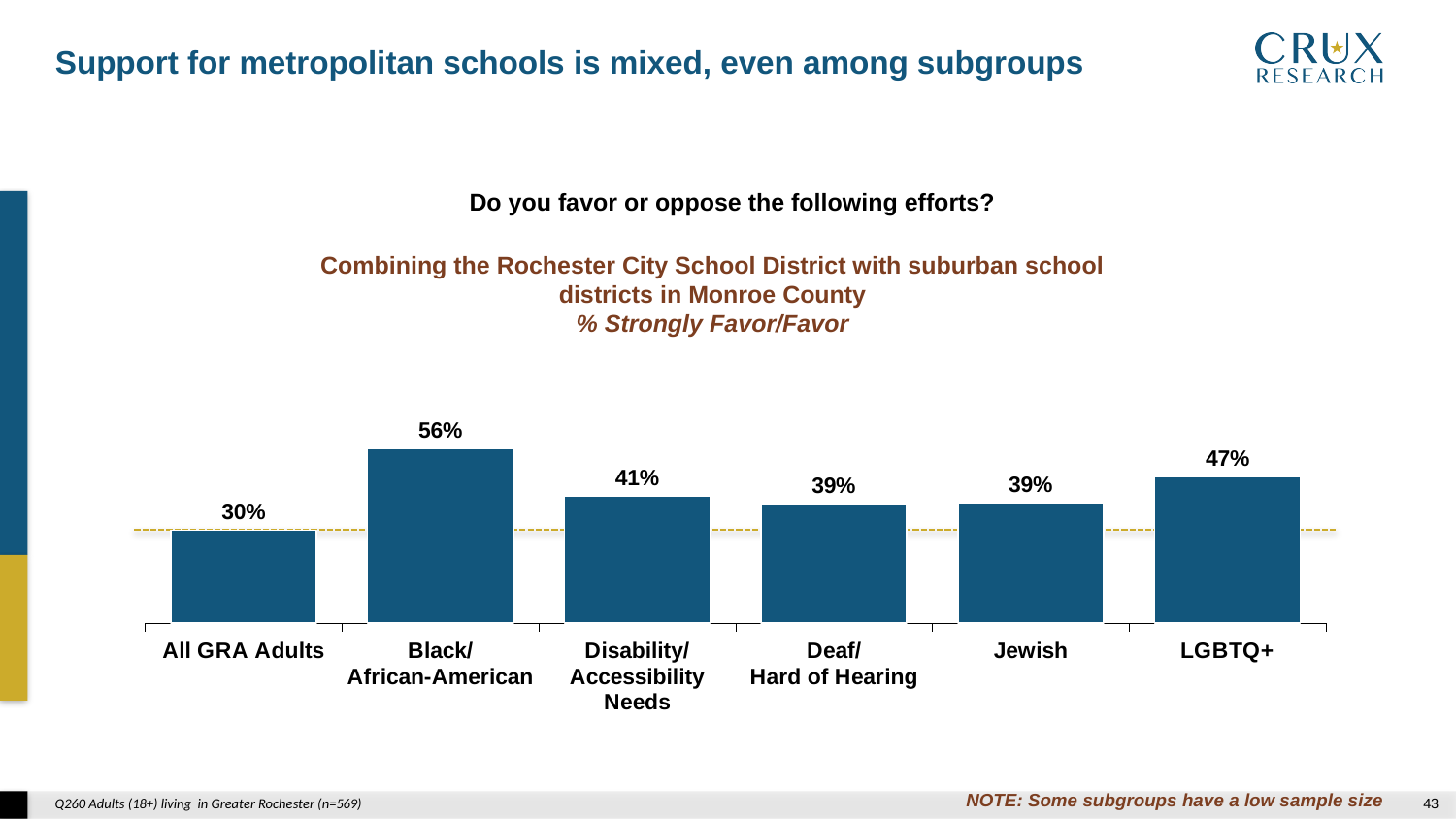
What is the value shown for the Black/African-American subgroup? 56% What is the value shown for the LGBTQ+ subgroup? 47% What is the difference in percentage points between LGBTQ+ and Jewish respondents? 8 Which two subgroups share the same value of 39%? Deaf/Hard of Hearing and Jewish Which category has the lowest percentage favoring the effort? All GRA Adults How many categories are shown in the chart? 6 Which subgroup has the highest percentage favoring the effort? Black/African-American What percentage of All GRA Adults strongly favor or favor combining the Rochester City School District with suburban school districts? 30% What kind of chart is shown on the slide? Bar chart Which is larger, the value for LGBTQ+ or the value for Deaf/Hard of Hearing? LGBTQ+ What is the difference in percentage points between the Black/African-American subgroup and All GRA Adults? 26 What is the value shown for the Disability/Accessibility Needs subgroup? 41%